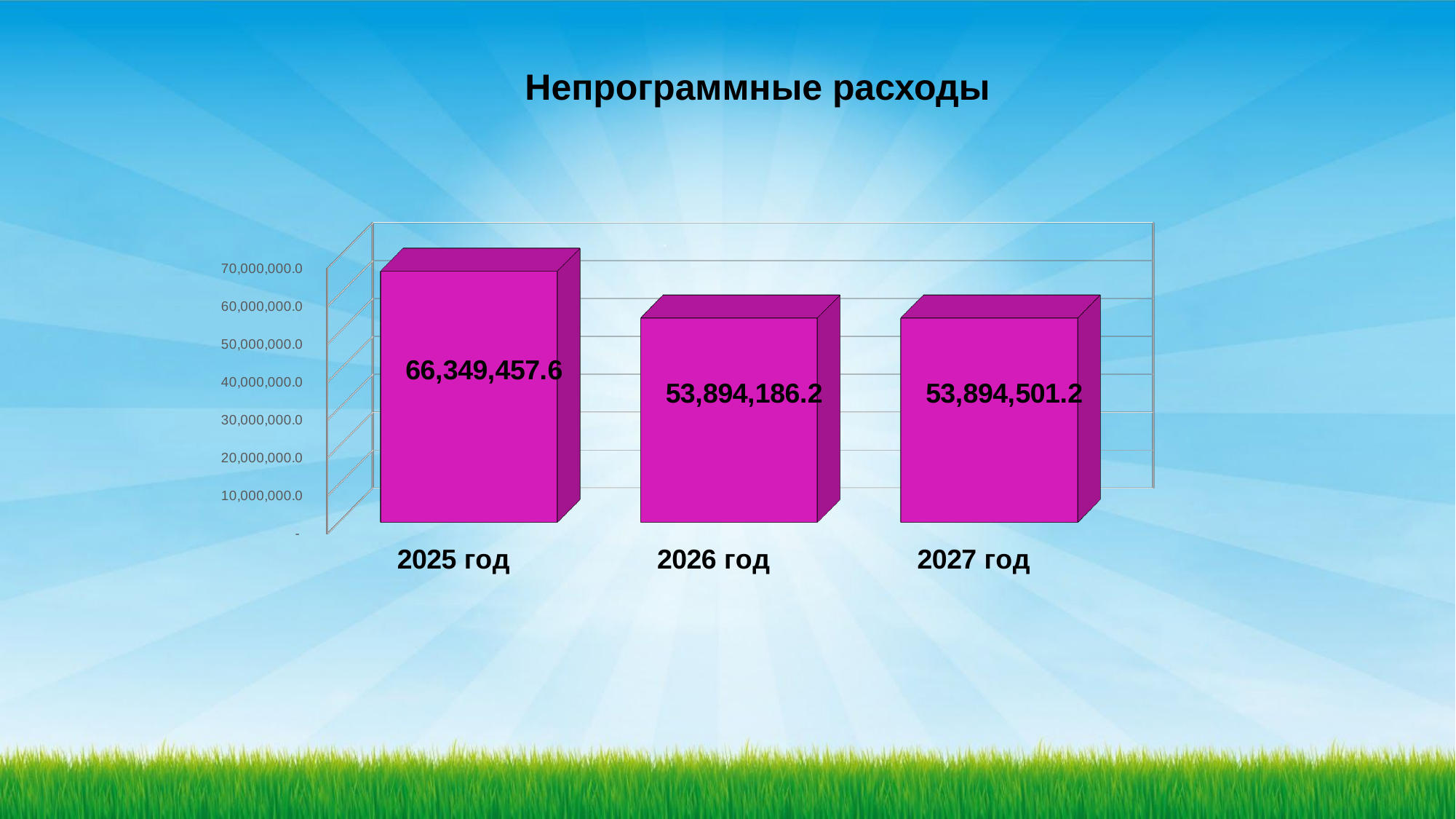
Which year has the highest value? 2025 год Is the value for 2026 год greater or less than 60,000,000.0? less Is the value for 2025 год greater or less than 60,000,000.0? greater What is the value for 2025 год? 66,349,457.6 What is the difference between the values for 2027 год and 2026 год? 315.0 What kind of chart is shown on the slide? bar chart How many years are shown on the chart? 3 Which is larger, the value for 2025 год or the value for 2027 год? 2025 год What is the value for 2027 год? 53,894,501.2 What is the value for 2026 год? 53,894,186.2 What is the difference between the values for 2025 год and 2026 год? 12,455,271.4 What is the title of the chart? Непрограммные расходы